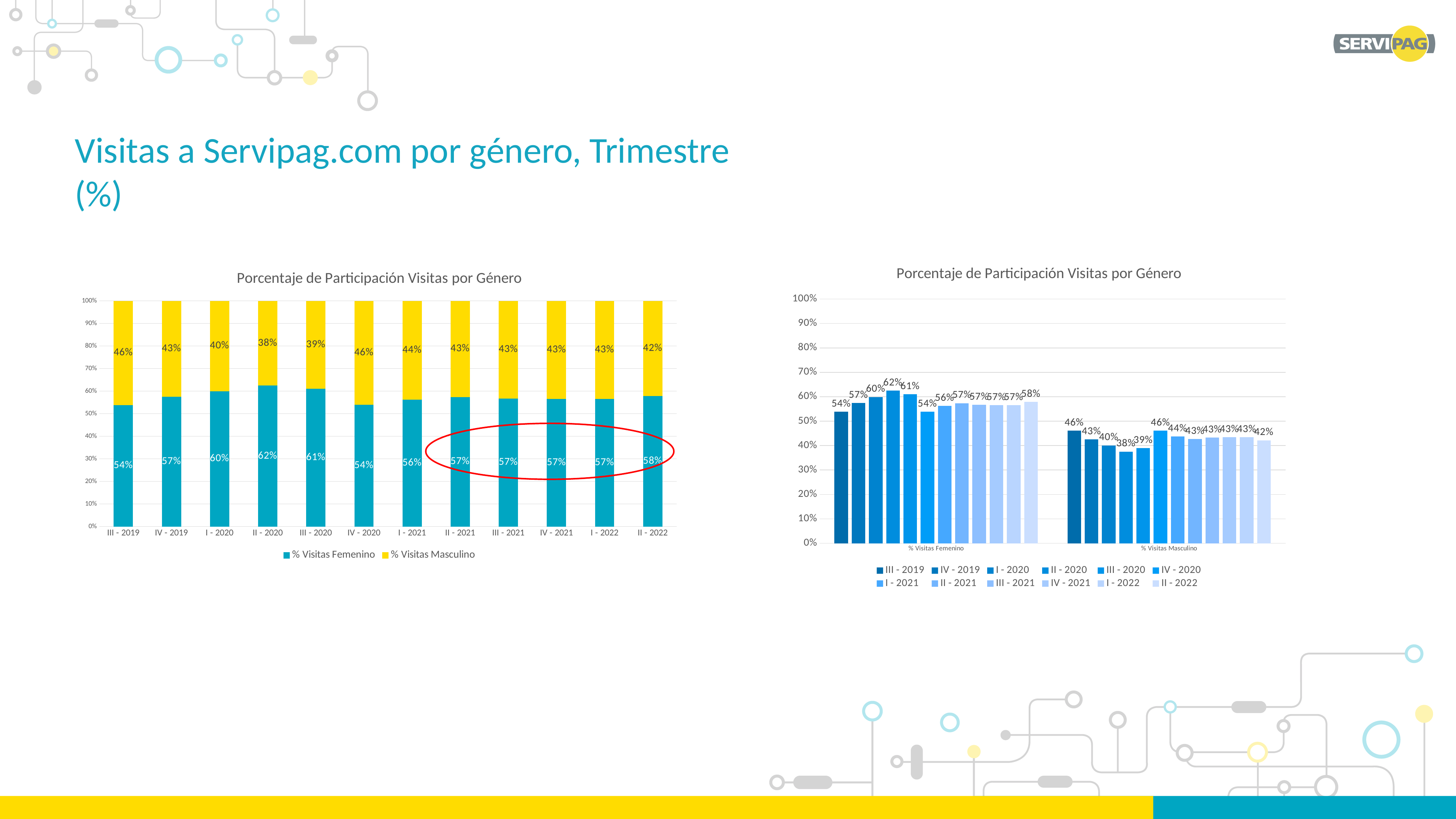
How many series does the legend of the left chart list? 2 In the left chart, what is the total of the stacked bar for II - 2022? 100% In the left chart, which quarter has the lowest % Visitas Masculino value? II - 2020 In the right chart, what is the % Visitas Masculino value for the II - 2022 series? 42% In the left chart, what is the difference between the % Visitas Femenino and % Visitas Masculino values for III - 2019? 8% In the left chart, what is the % Visitas Masculino value for IV - 2020? 46% How many series does the legend of the right chart list? 12 How many quarters are shown on the x axis of the left chart? 12 In the left chart, which quarter has the highest % Visitas Femenino value? II - 2020 What kind of chart is the left chart? Stacked bar chart In the left chart, which is larger: the % Visitas Femenino value for I - 2020 or for IV - 2020? I - 2020 In the left chart, what is the % Visitas Femenino value for II - 2020? 62%